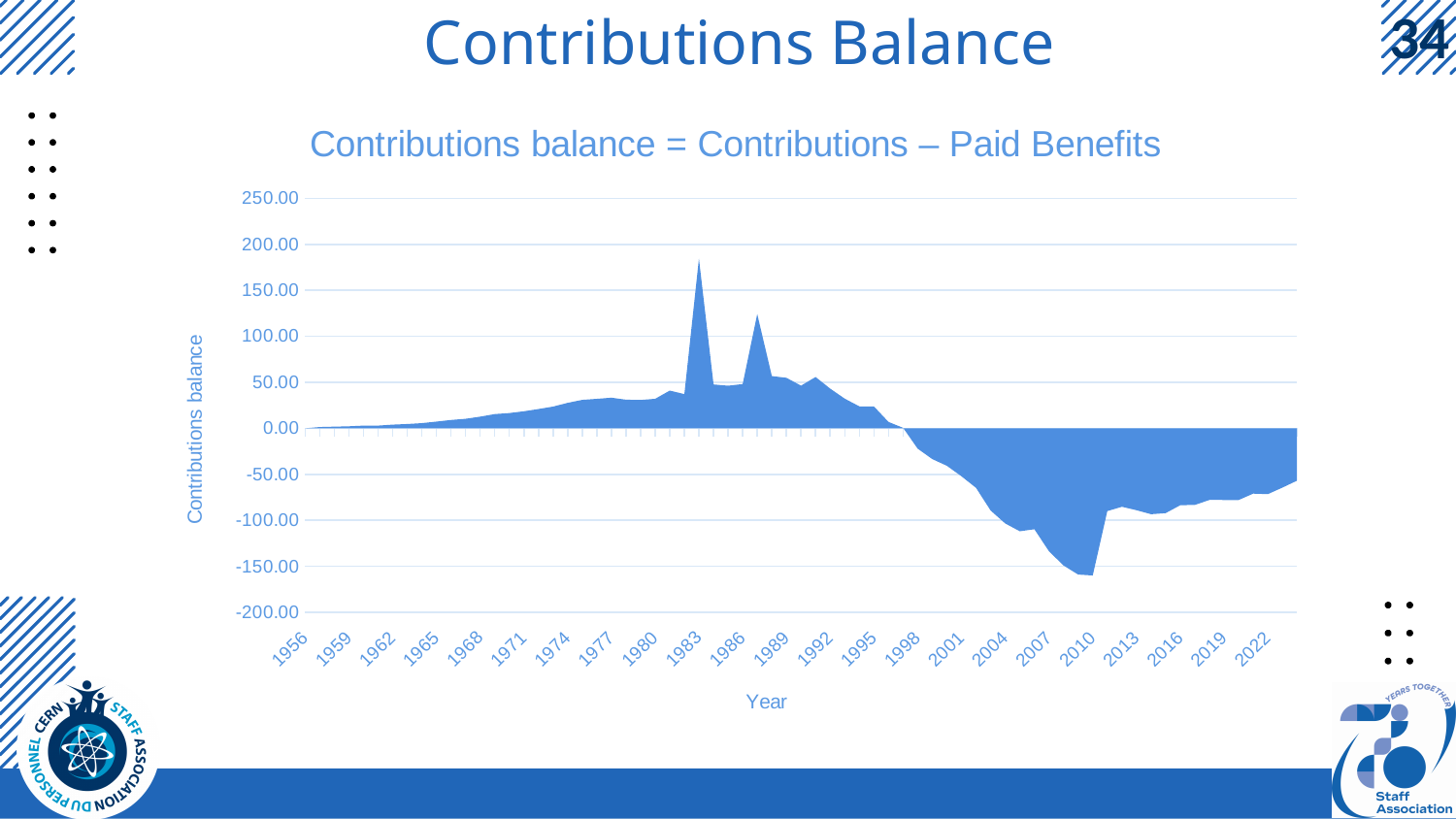
Is the contributions balance for 1977 greater or less than 50.00? less In which labelled year does the contributions balance reach its highest peak? 1983 Is the contributions balance for 2022 greater or less than 0.00? less Which year has the higher contributions balance, 1983 or 1986? 1983 What is the title of the chart? Contributions balance = Contributions – Paid Benefits Does the contributions balance rise or fall between 1998 and 2010? fall Is the contributions balance for 1983 greater or less than 150.00? greater What is the label of the vertical axis? Contributions balance What kind of chart is shown on the slide? Area chart How many year labels are shown on the x axis? 23